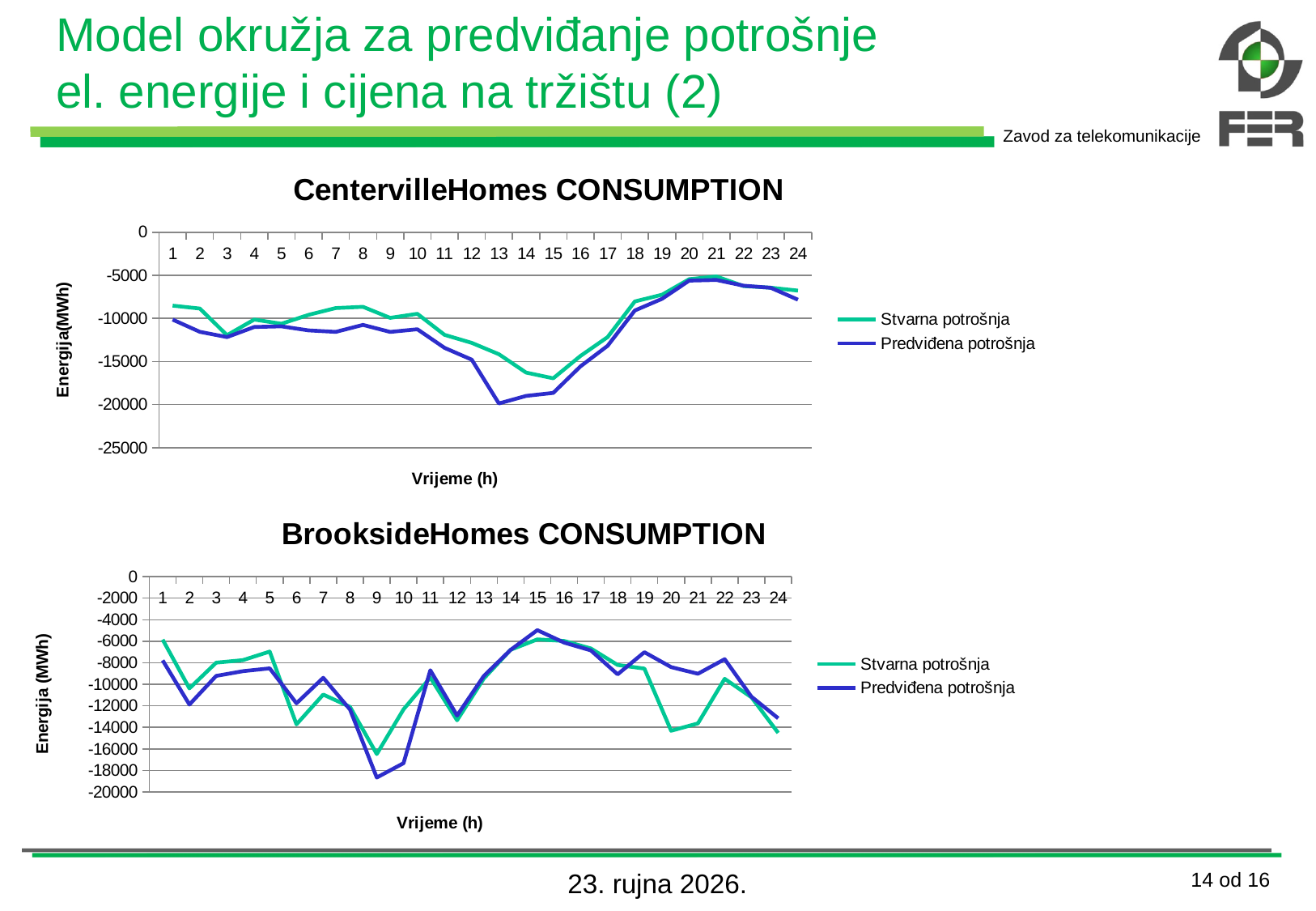
How many series does the legend of the BrooksideHomes CONSUMPTION chart list? 2 In the CentervilleHomes CONSUMPTION chart, at which hour does the Predviđena potrošnja series reach its lowest value? 13 In the CentervilleHomes CONSUMPTION chart, is the Predviđena potrošnja value at hour 13 greater or less than -15000? less In the BrooksideHomes CONSUMPTION chart, is the Predviđena potrošnja value at hour 9 greater or less than -15000? less What type of chart is the CentervilleHomes CONSUMPTION chart? line chart How many hourly points are plotted along the x axis of the CentervilleHomes CONSUMPTION chart? 24 In the BrooksideHomes CONSUMPTION chart, at which hour does the Predviđena potrošnja series reach its highest value? 15 In the CentervilleHomes CONSUMPTION chart, at hour 13, which series has the larger value, Stvarna potrošnja or Predviđena potrošnja? Stvarna potrošnja What is the y-axis title of the BrooksideHomes CONSUMPTION chart? Energija (MWh) In the CentervilleHomes CONSUMPTION chart, is the Stvarna potrošnja value at hour 1 greater or less than -10000? greater In the BrooksideHomes CONSUMPTION chart, at which hour does the Predviđena potrošnja series reach its lowest value? 9 In the BrooksideHomes CONSUMPTION chart, at hour 20, which series has the larger value, Stvarna potrošnja or Predviđena potrošnja? Predviđena potrošnja